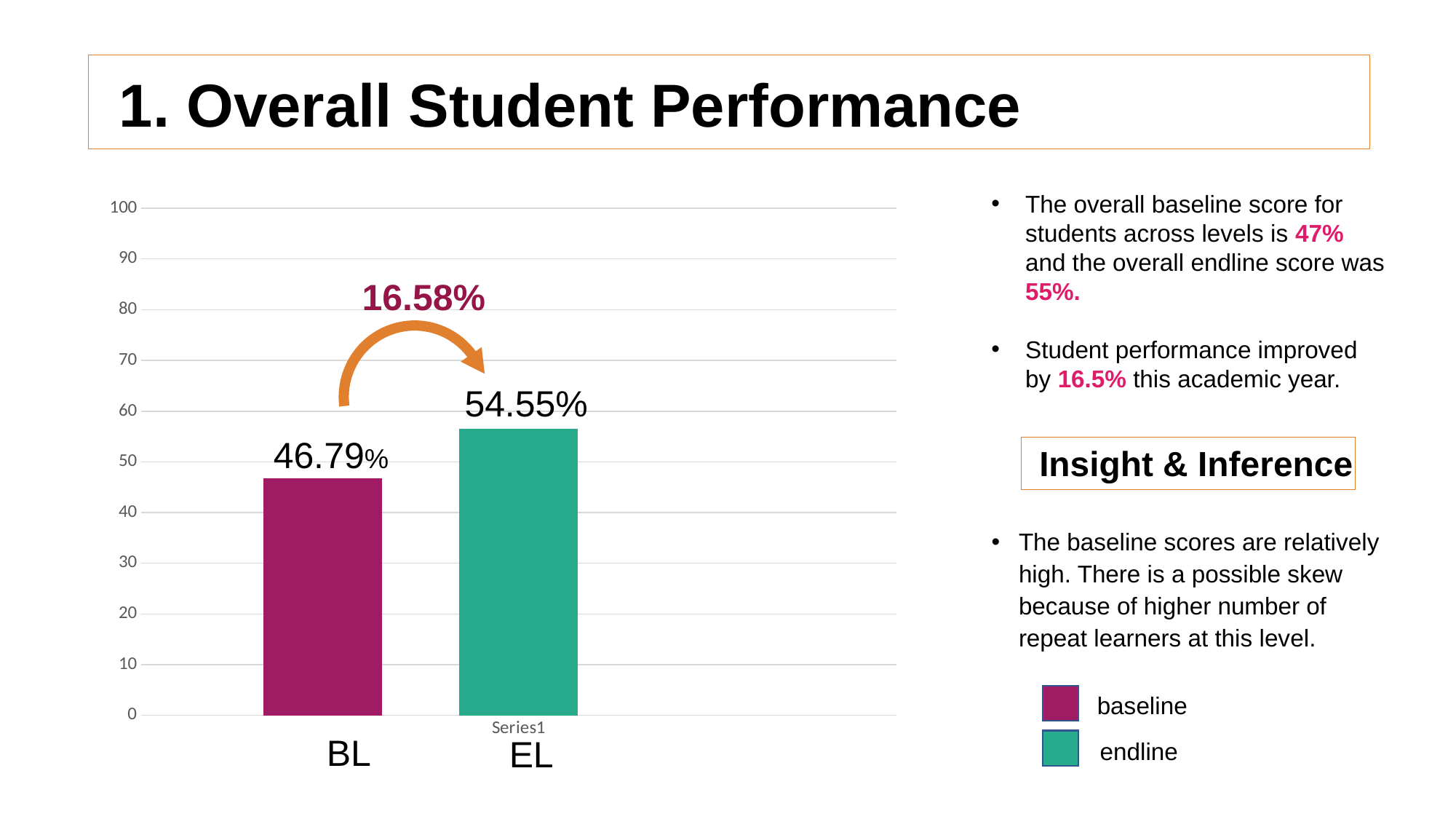
Is the value for BL larger than the value for EL? No What kind of chart is shown on the slide? Bar chart What percentage is written above the orange arrow between the two bars? 16.58% Which bar is the lowest? BL How many bars are plotted in the chart? 2 What is the value shown for BL? 46.79% Is the value for BL greater or less than 50? less What is the difference between the EL value and the BL value? 7.76% What is the value shown for EL? 54.55% Is the value for EL greater or less than 50? greater Do the values rise or fall from BL to EL? Rise Which bar is higher, BL or EL? EL